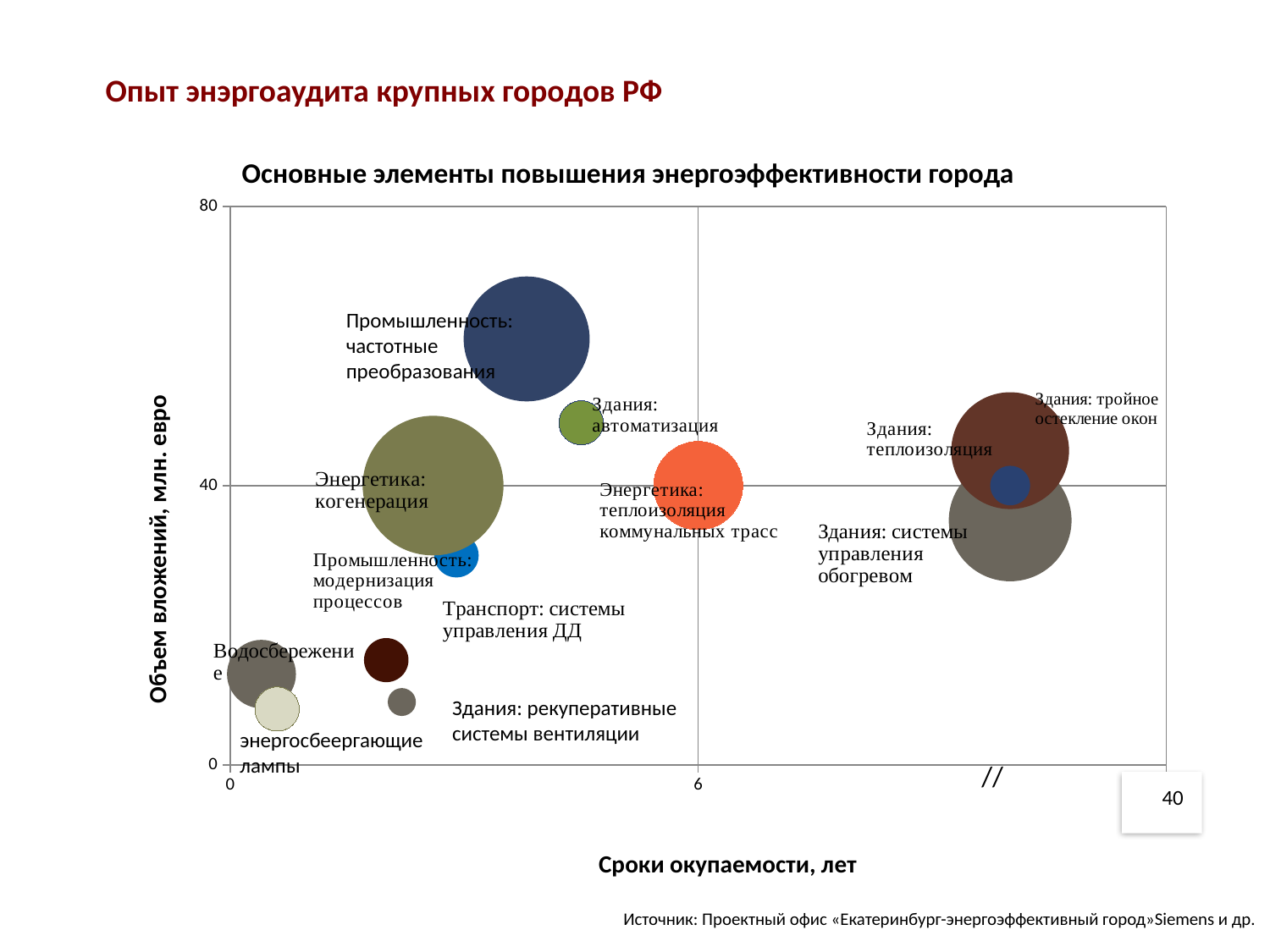
Is the investment volume (y value) for "Водосбережение" greater or less than 40? less Which element has the highest investment volume on the chart? Промышленность: частотные преобразования What is the title of the chart? Основные элементы повышения энергоэффективности города Is the payback period (x value) for "Здания: тройное остекление окон" greater or less than 6 years? greater How many bubbles (elements) are plotted on the chart? 12 What kind of chart is shown on the slide? Bubble chart Which has a higher investment volume: "Промышленность: частотные преобразования" or "Водосбережение"? Промышленность: частотные преобразования Is the payback period (x value) for "Промышленность: частотные преобразования" greater or less than 6 years? less What is the label of the vertical axis of the chart? Объем вложений, млн. евро